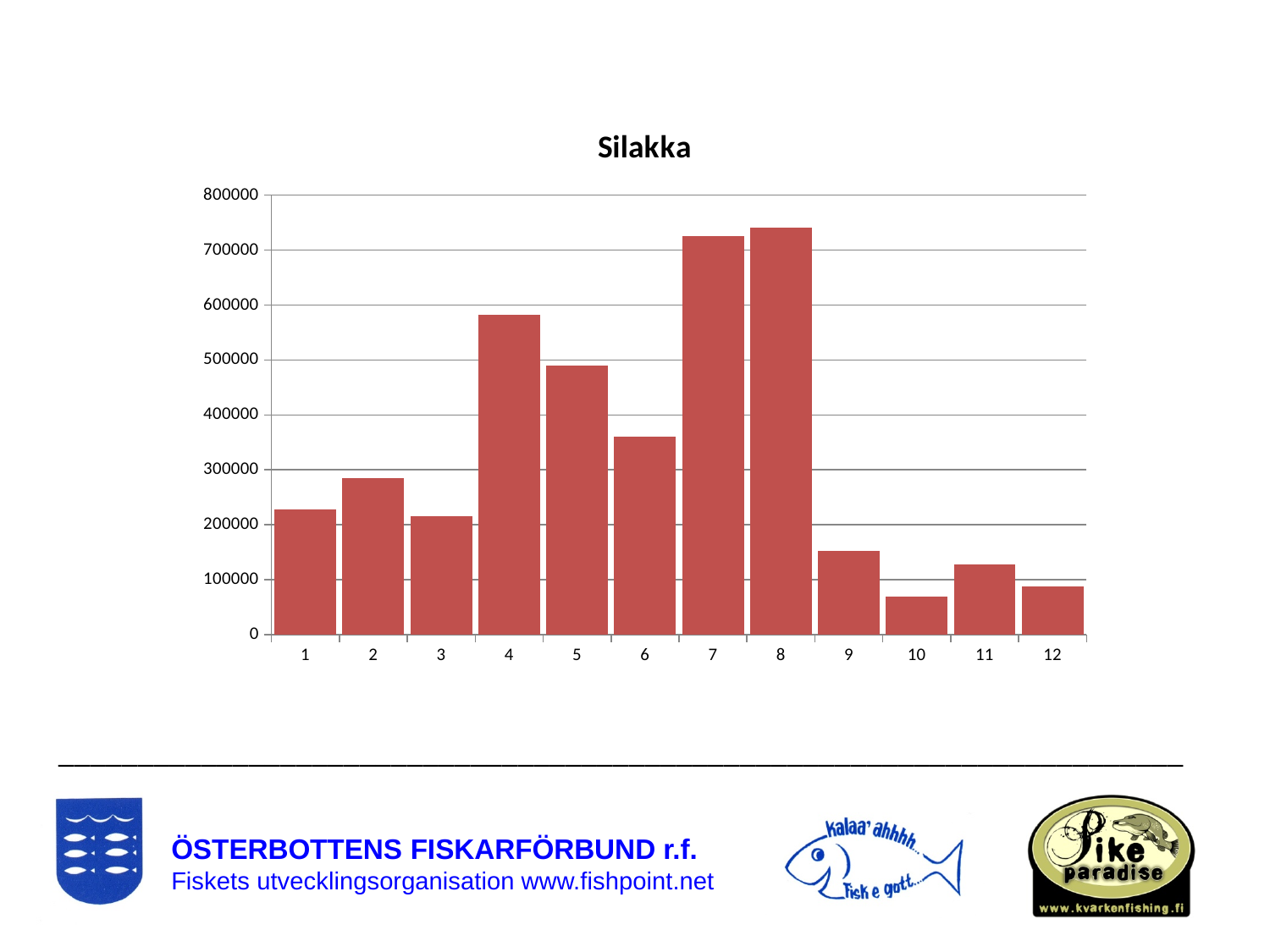
Is the value for category 4 greater or less than 500000? greater Which has the larger value, category 11 or category 12? 11 Which category has the lowest value in the chart? 10 Is the value for category 10 greater or less than 100000? less Do the values rise or fall from category 8 to category 10? fall What kind of chart is shown on the slide? bar chart Which has the larger value, category 4 or category 5? 4 Is the value for category 7 greater or less than 700000? greater How many categories are shown on the x axis of the chart? 12 What is the title of the chart? Silakka